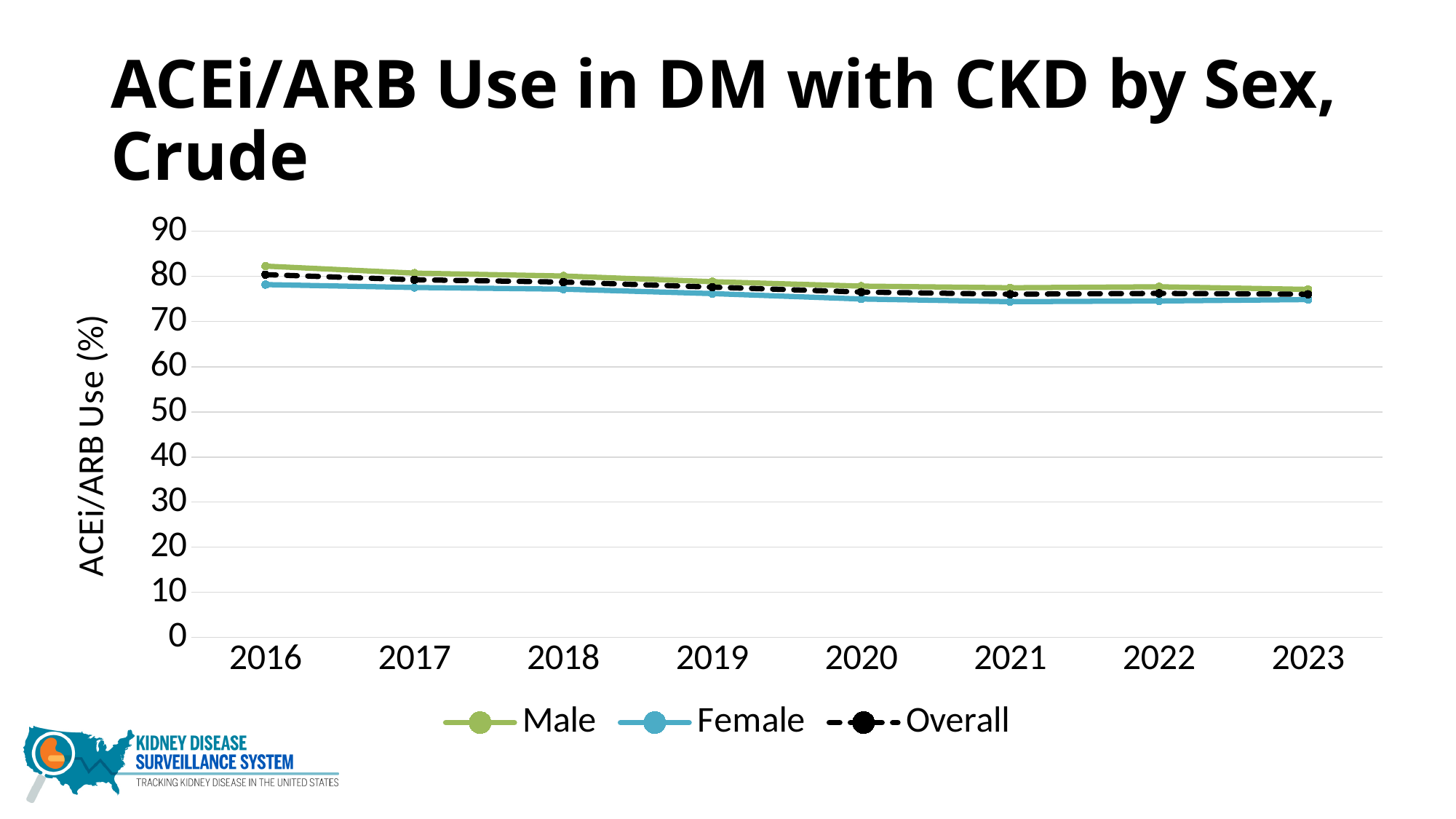
Which series has the lowest value in 2020? Female Does the Male series rise or fall from 2016 to 2023? fall Is the value for Overall in 2023 greater or less than 80? less What kind of chart is shown on the slide? line chart How many series does the legend list? 3 Which series has the highest value in 2016? Male Which is larger in 2023, the value for Male or the value for Female? Male How many years are plotted along the x axis? 8 Is the value for Female in 2023 greater or less than 70? greater Is the value for Male in 2016 greater or less than 80? greater What is the label on the y axis? ACEi/ARB Use (%)